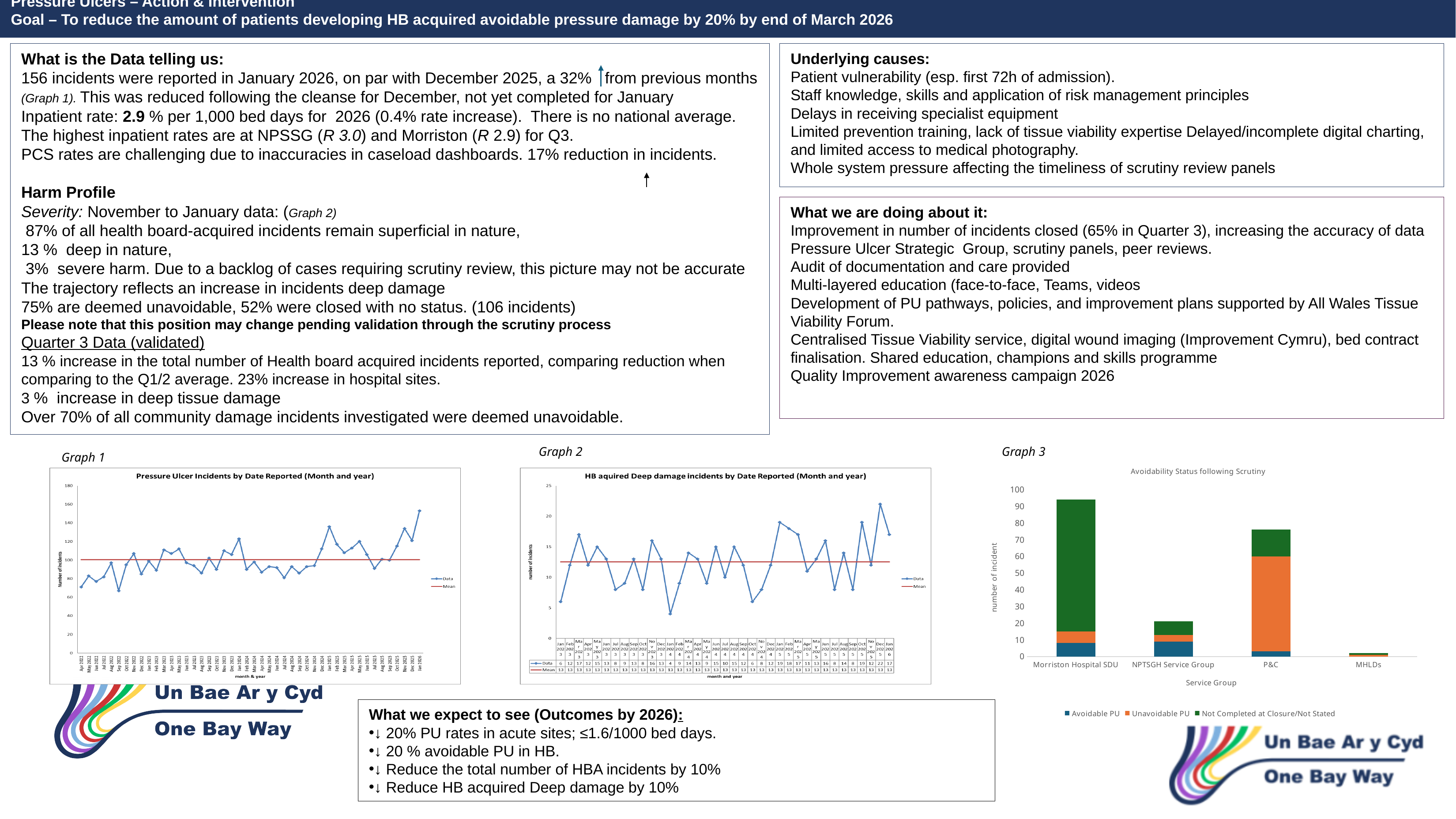
In Graph 2, 'HB aquired Deep damage incidents by Date Reported (Month and year)', what is the Mean value shown in the data table? 13 What kind of chart is Graph 1, 'Pressure Ulcer Incidents by Date Reported (Month and year)'? line chart What kind of chart is Graph 3, 'Avoidability Status following Scrutiny'? bar chart In Graph 3, 'Avoidability Status following Scrutiny', is the total bar for Morriston Hospital SDU greater or less than 90? greater In Graph 2, 'HB aquired Deep damage incidents by Date Reported (Month and year)', what is the Data value for Dec 2025? 22 In Graph 3, 'Avoidability Status following Scrutiny', how many series does the legend list? 3 In Graph 3, 'Avoidability Status following Scrutiny', is the total bar for NPTSGH Service Group greater or less than 30? less In Graph 3, 'Avoidability Status following Scrutiny', which service group has the shortest stacked bar? MHLDs In Graph 3, 'Avoidability Status following Scrutiny', which is larger: the total bar for P&C or the total bar for NPTSGH Service Group? P&C In Graph 3, 'Avoidability Status following Scrutiny', which service group has the tallest stacked bar? Morriston Hospital SDU In Graph 3, 'Avoidability Status following Scrutiny', how many service groups are shown on the x axis? 4 In Graph 1, 'Pressure Ulcer Incidents by Date Reported (Month and year)', how many series does the legend list? 2